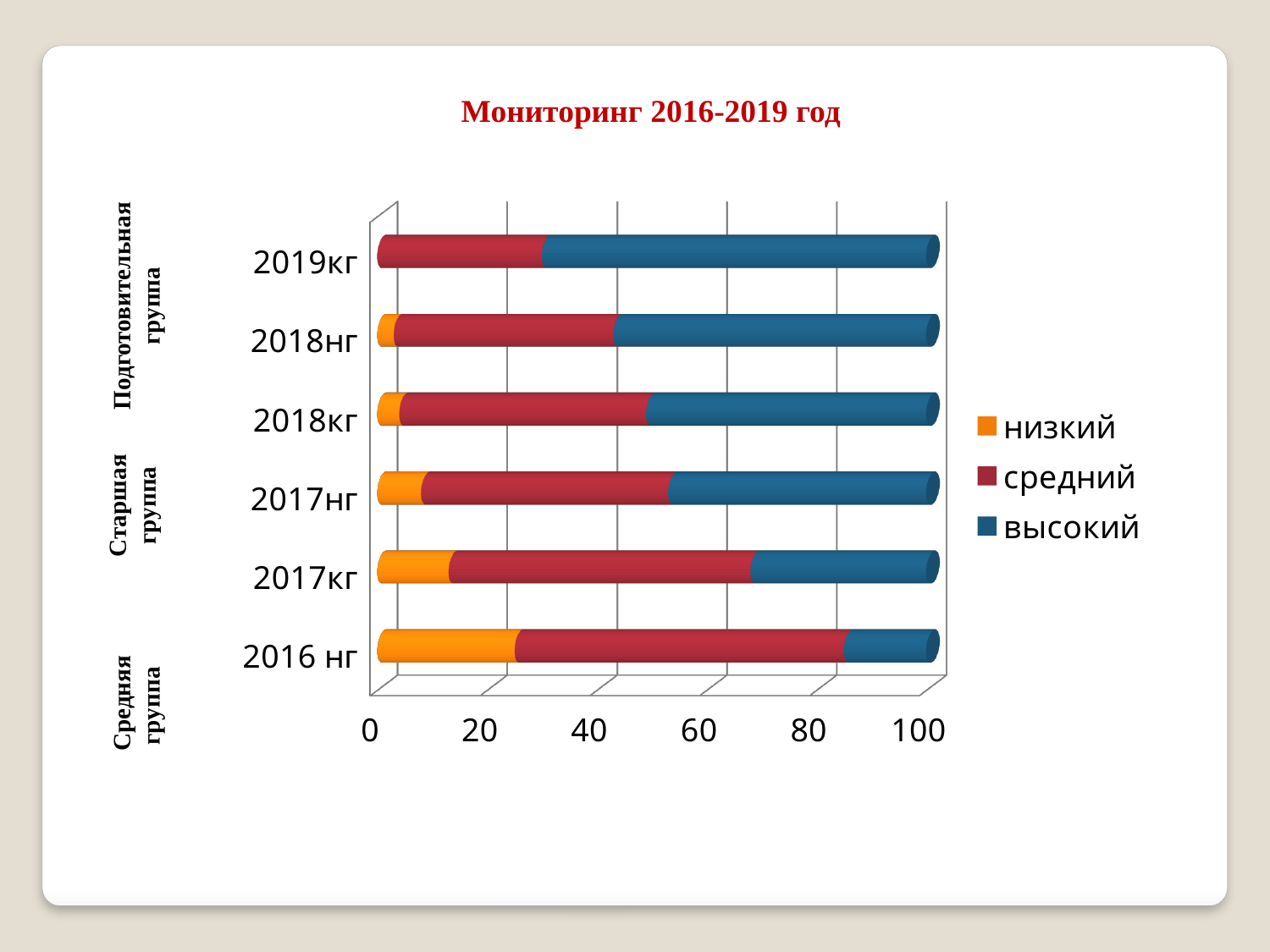
How many series does the legend list? 3 Which category has the largest высокий segment? 2019кг Which is larger, the высокий value for 2017кг or the высокий value for 2016 нг? 2017кг Which series is shown in blue in the legend? высокий Is the высокий value for 2019кг greater or less than 60? greater Is the низкий value for 2016 нг greater or less than 20? greater What kind of chart is shown on the slide? stacked bar chart Which category has the largest низкий segment? 2016 нг How many categories are plotted on the vertical axis of the chart? 6 Is the низкий value for 2017кг greater or less than 20? less What is the title of the chart? Мониторинг 2016-2019 год Which category has the smallest высокий segment? 2016 нг